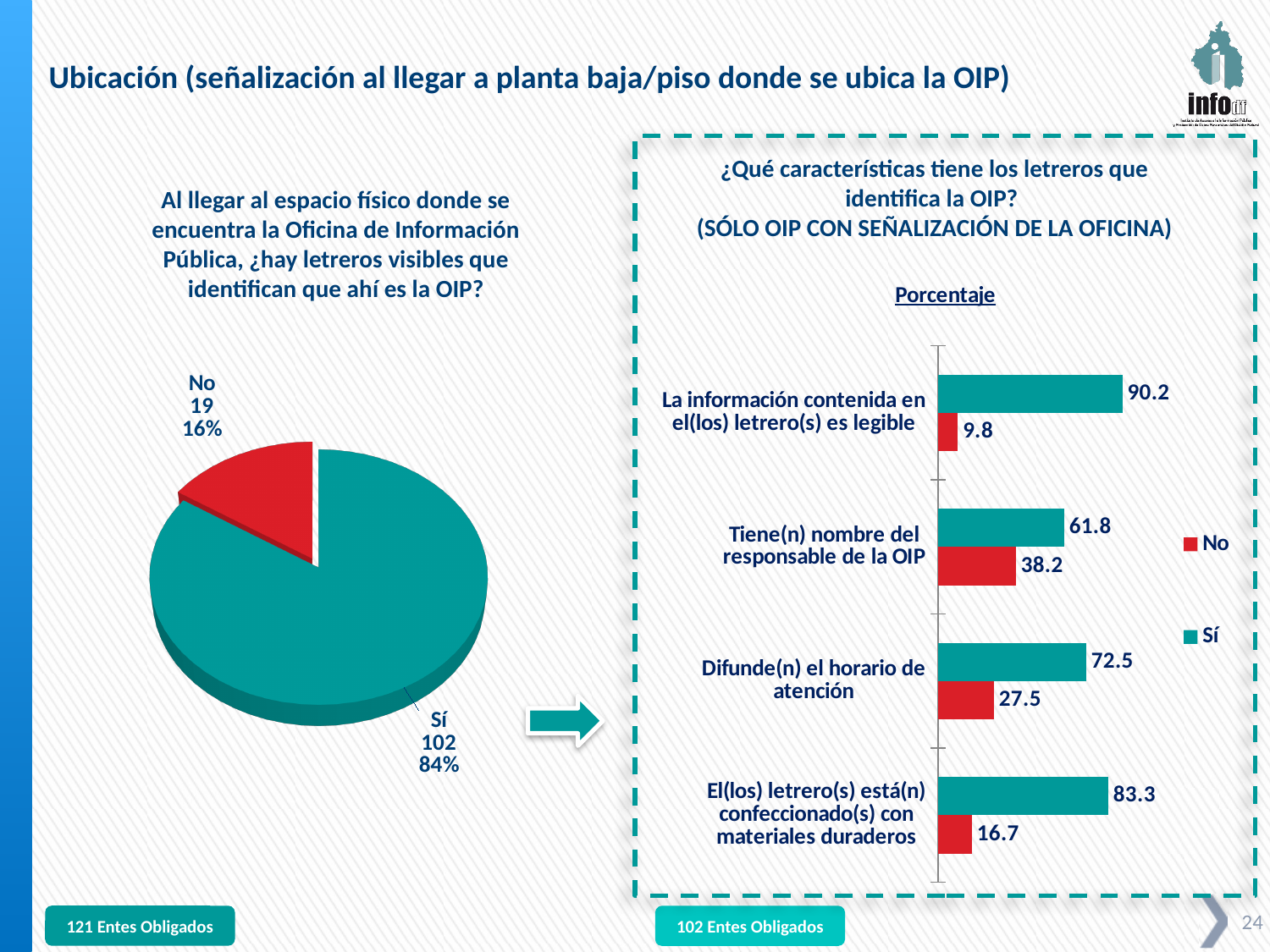
In the bar chart on the right, which category has the highest 'Sí' value? La información contenida en el(los) letrero(s) es legible How many categories does the bar chart on the right show? 4 In the bar chart on the right, which category has the lowest 'Sí' value? Tiene(n) nombre del responsable de la OIP What kind of chart is shown on the right side of the slide? Bar chart In the bar chart on the right, what is the 'No' value for 'Tiene(n) nombre del responsable de la OIP'? 38.2 In the pie chart on the left, which slice is larger, 'Sí' or 'No'? Sí How many series does the legend of the bar chart on the right list? 2 In the bar chart on the right, what is the 'Sí' value for 'La información contenida en el(los) letrero(s) es legible'? 90.2 In the pie chart on the left, what percentage of entities answered 'Sí'? 84% In the bar chart on the right, what is the difference between the 'Sí' and 'No' values for 'Difunde(n) el horario de atención'? 45 In the pie chart on the left, how many entities answered 'No'? 19 What kind of chart is shown on the left side of the slide? Pie chart